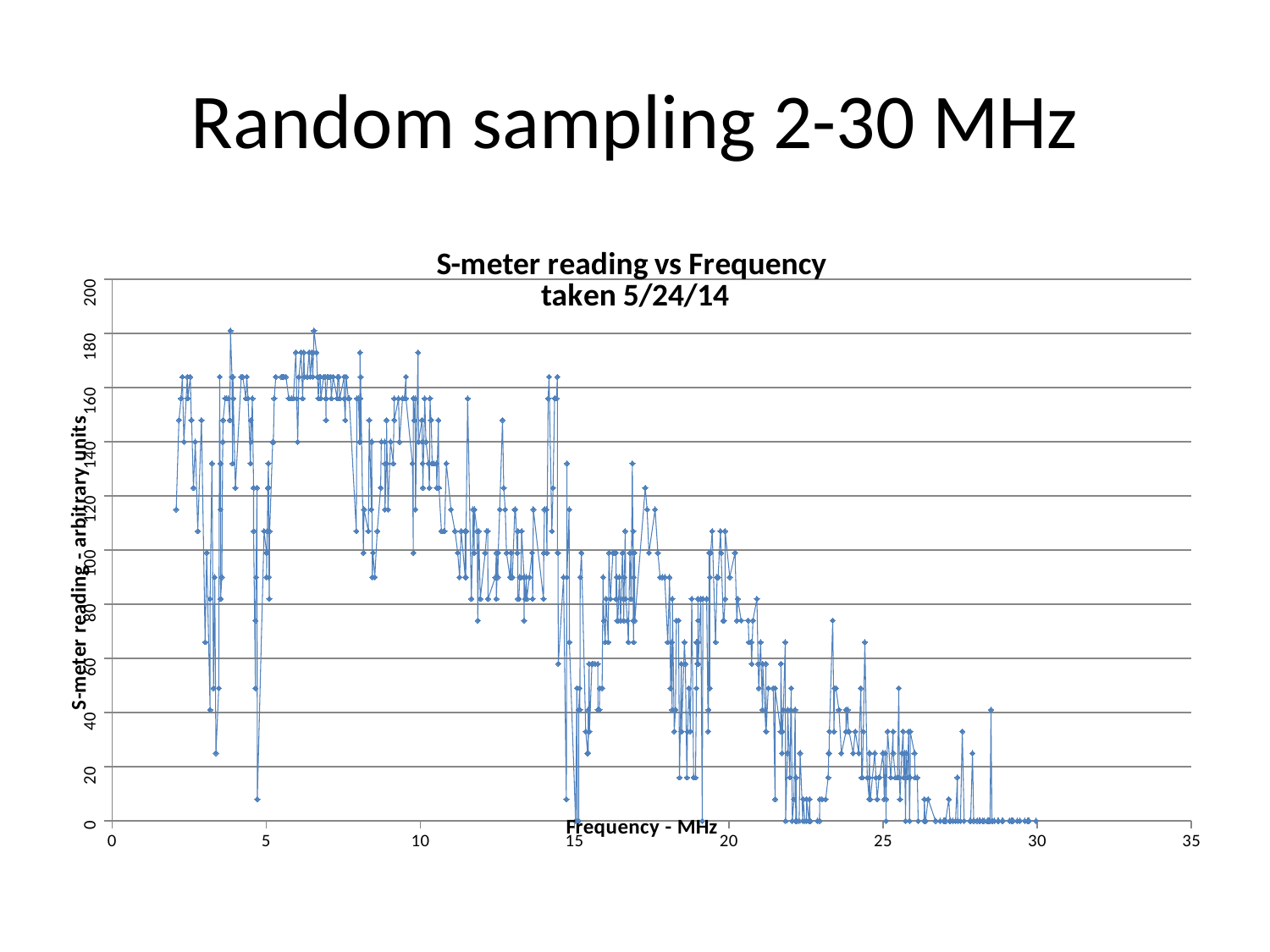
Is the S-meter reading at about 30 MHz greater or less than 20? less What is the title of the chart? S-meter reading vs Frequency taken 5/24/14 Overall, do the S-meter readings rise or fall as frequency increases from 2 to 30 MHz? fall Are the S-meter readings around 29.5 MHz greater or less than 40? less What is the label of the vertical axis of the chart? S-meter reading - arbitrary units Is the highest S-meter reading on the chart greater or less than 160? greater What kind of chart is shown on the slide? line chart Which has lower S-meter readings: the region around 3 MHz or the region around 29 MHz? around 29 MHz Which has higher S-meter readings: the region around 6 MHz or the region around 26 MHz? around 6 MHz